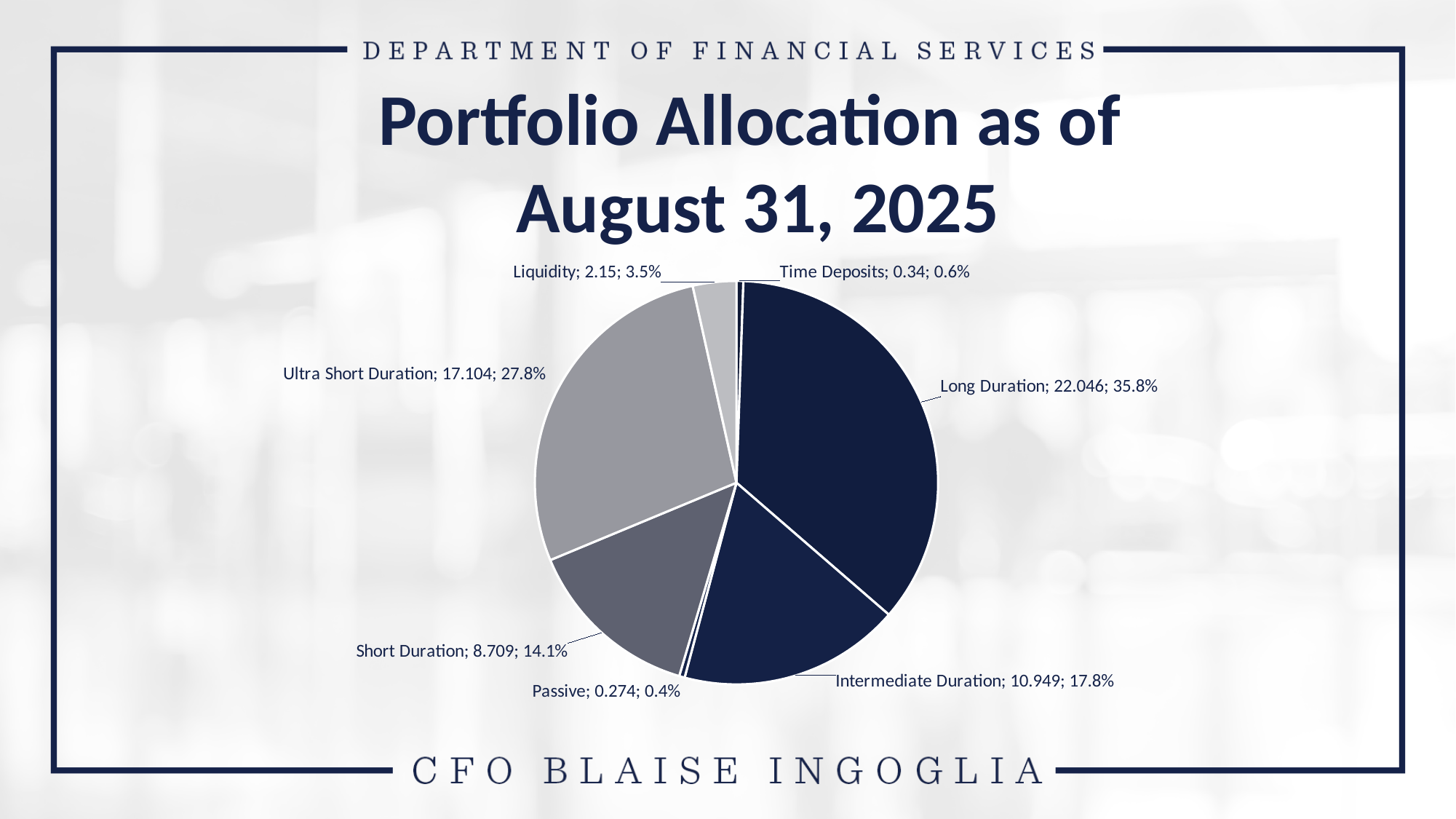
What value is shown for Time Deposits? 0.34 What is the title of the chart on the slide? Portfolio Allocation as of August 31, 2025 What value is shown for Long Duration? 22.046 What kind of chart is shown on the slide? Pie chart What percentage share does Ultra Short Duration have? 27.8% Which category has the largest slice of the pie? Long Duration Which category has the smallest slice of the pie? Passive How many slices does the pie chart have? 7 What is the difference between the values for Long Duration and Ultra Short Duration? 4.942 What percentage share does Liquidity have? 3.5% What value is shown for Intermediate Duration? 10.949 Which is larger, Short Duration or Intermediate Duration? Intermediate Duration